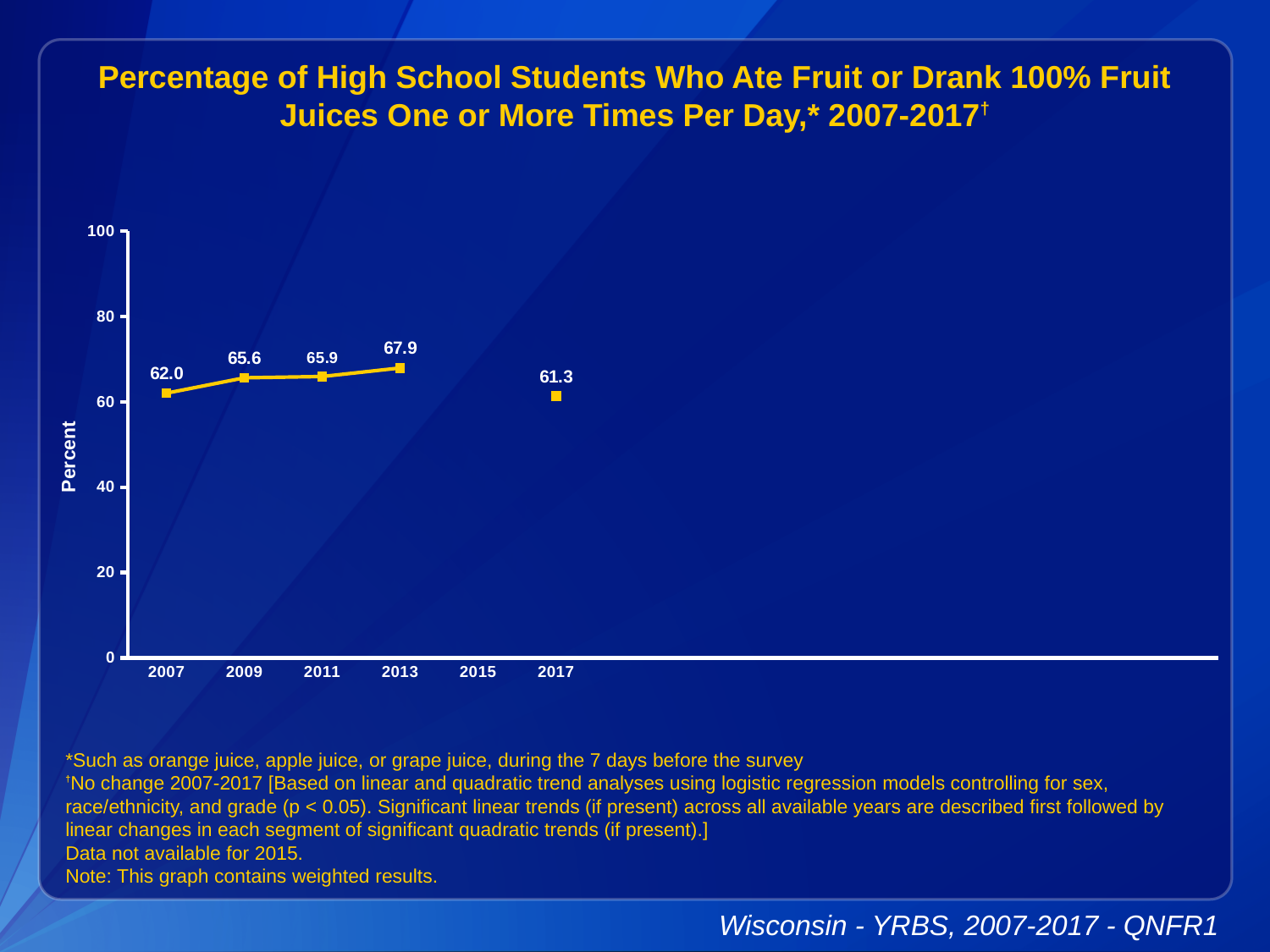
Which year has the lowest value? 2017 Is the value for 2013 greater or less than 80? less What is the difference between the values for 2013 and 2007? 5.9 What is the value for 2013? 67.9 Which year has the highest value? 2013 Which is larger, the value for 2009 or the value for 2017? 2009 How many data points are plotted on the chart? 5 What is the value for 2011? 65.9 What is the value for 2017? 61.3 What kind of chart is shown on the slide? line chart What is the label on the y axis? Percent What is the value for 2007? 62.0